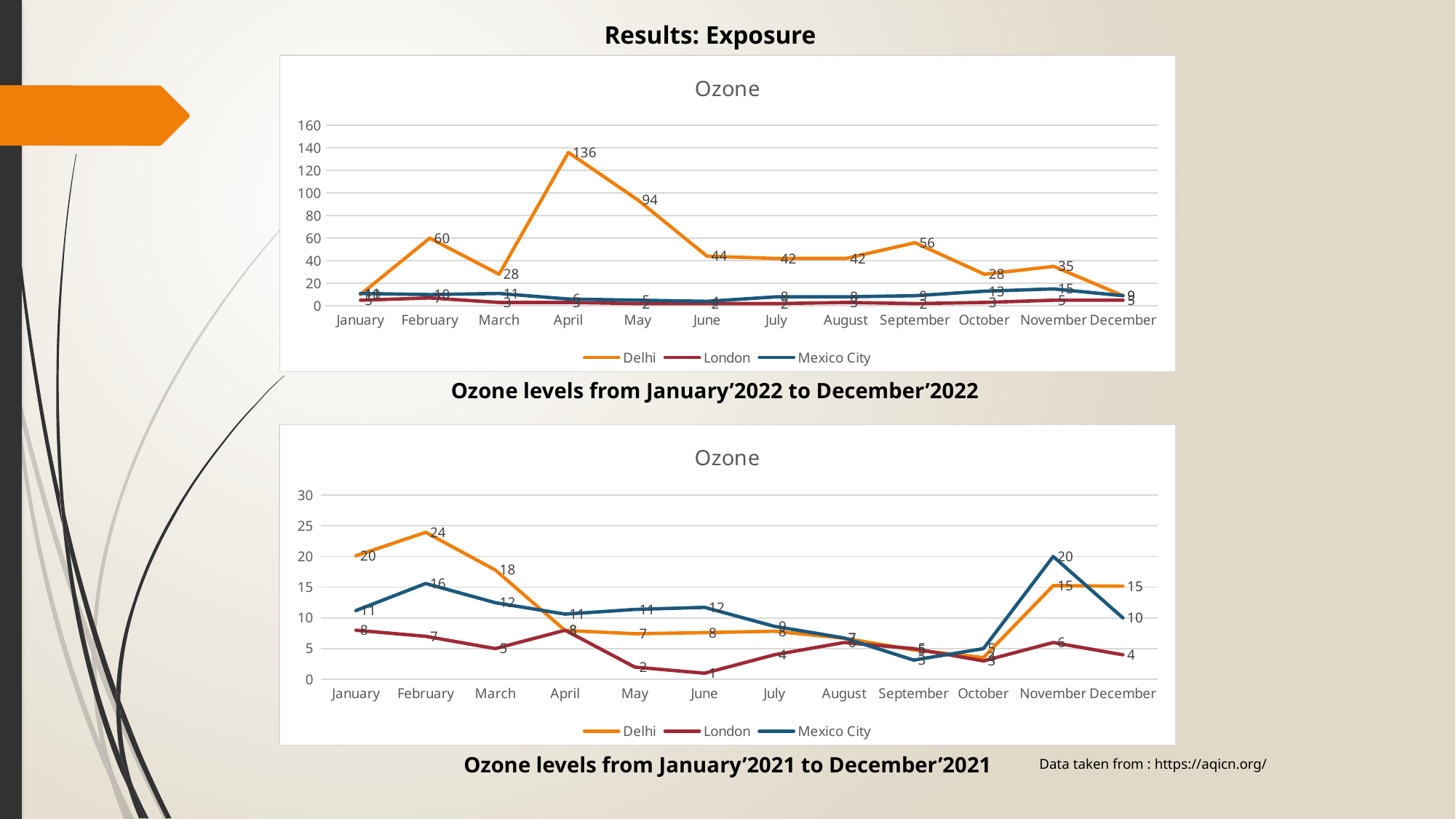
In the top chart (Ozone levels from January'2022 to December'2022), what is the Delhi value for April? 136 How many months are plotted along the x axis of the bottom chart? 12 How many series does the legend of the top chart list? 3 In the bottom chart (2021), what is the Mexico City value for November? 20 In the bottom chart (2021), in which month does London have its lowest value? June What kind of chart is the top chart? Line chart In the top chart (2022), in which month does Delhi reach its highest ozone value? April In the bottom chart (Ozone levels from January'2021 to December'2021), what is the Delhi value for February? 24 In the top chart (2022), is the Delhi value for May greater or less than 80? greater In the bottom chart (2021), which is larger in February: the Delhi value or the Mexico City value? Delhi In the top chart (2022), what is the difference between Delhi's April value and its May value? 42 In the top chart (2022), what is the Mexico City value for November? 15